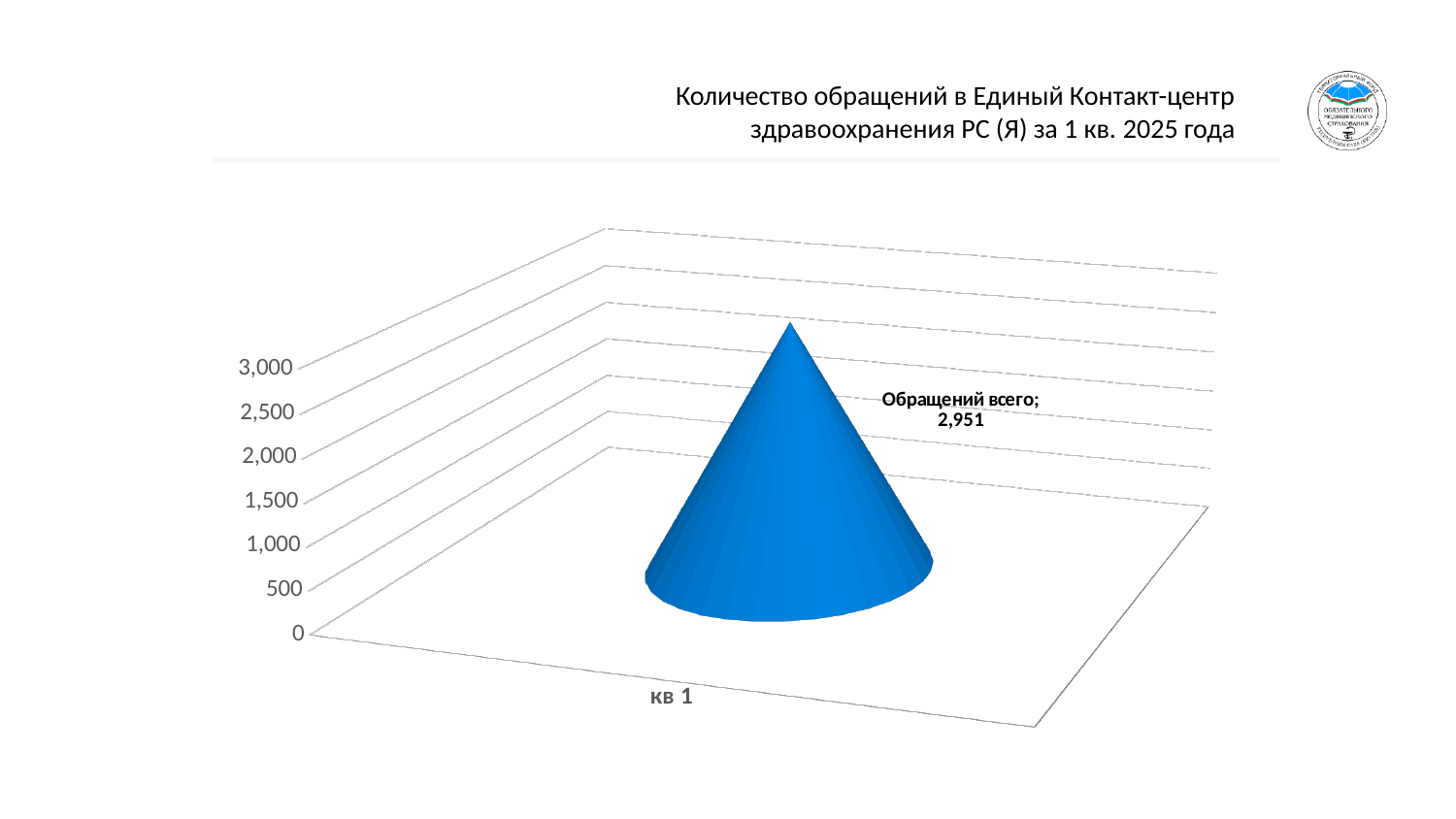
How many data series are plotted in the chart? 1 What is the value shown for кв 1? 2,951 What value is printed on the data label for the series Обращений всего? 2,951 Is the value for кв 1 greater or less than 3,000? less What kind of chart is shown on the slide? bar chart What is the highest tick value shown on the vertical axis? 3,000 What is the name of the series shown in the data label? Обращений всего Is the value for кв 1 greater or less than 2,500? greater What is the label of the single category on the x axis? кв 1 How many categories are plotted on the x axis? 1